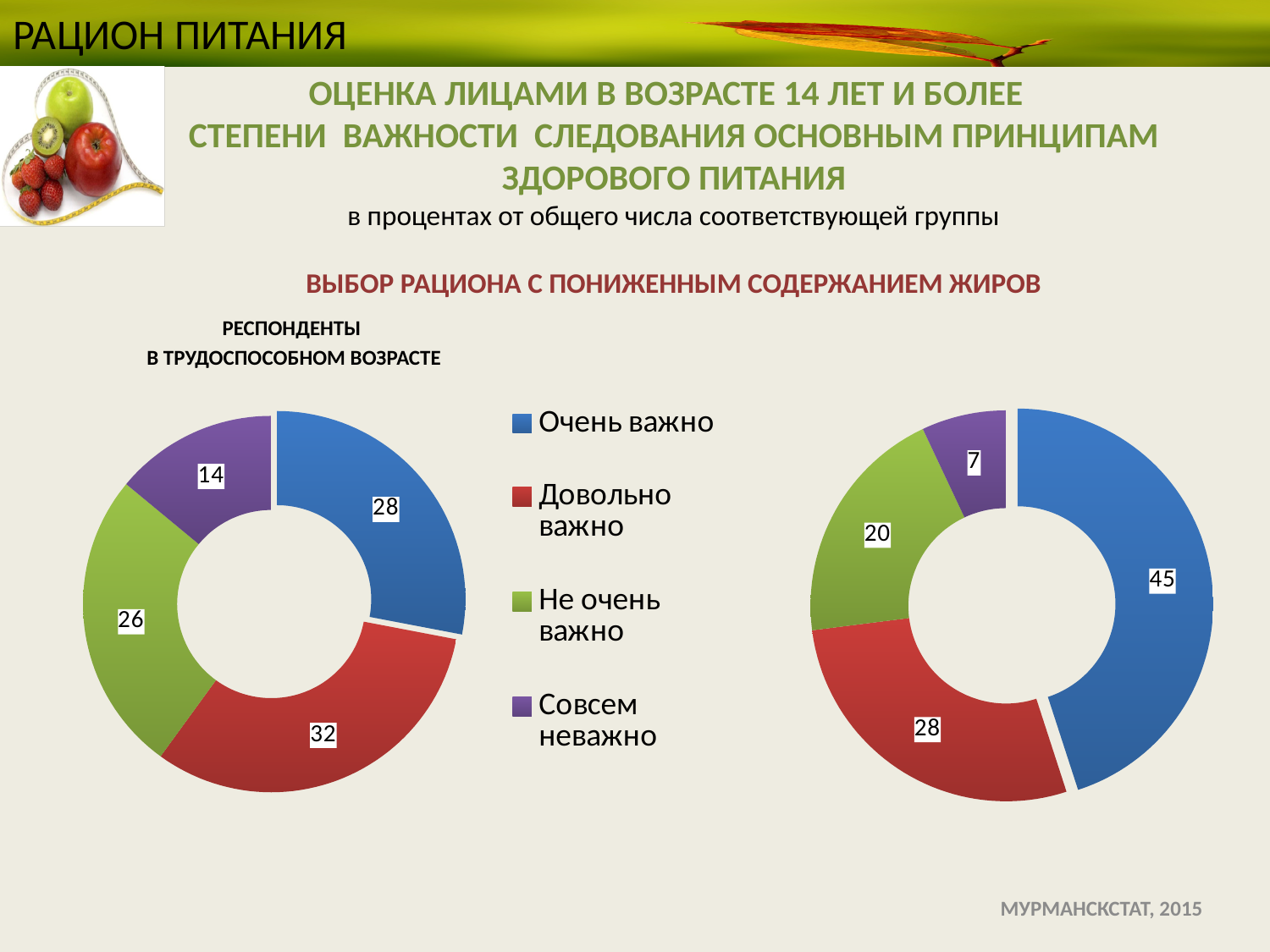
In the right chart, what is the value for 'Очень важно'? 45 In the left chart (Респонденты в трудоспособном возрасте), which is larger: 'Очень важно' or 'Не очень важно'? Очень важно In the right chart, what is the share of 'Совсем неважно' in the total? 7% In the right chart, which category has the smallest value? Совсем неважно What type of chart is the right chart? Doughnut chart How many categories does the left chart (Респонденты в трудоспособном возрасте) show? 4 In the right chart, what is the value for 'Не очень важно'? 20 In the left chart (Респонденты в трудоспособном возрасте), what is the value for 'Совсем неважно'? 14 In the left chart (Респонденты в трудоспособном возрасте), which category has the largest value? Довольно важно In the right chart, what is the difference between the values for 'Очень важно' and 'Довольно важно'? 17 In the left chart (Респонденты в трудоспособном возрасте), what is the value for 'Довольно важно'? 32 What colour represents 'Не очень важно' in the legend? Green